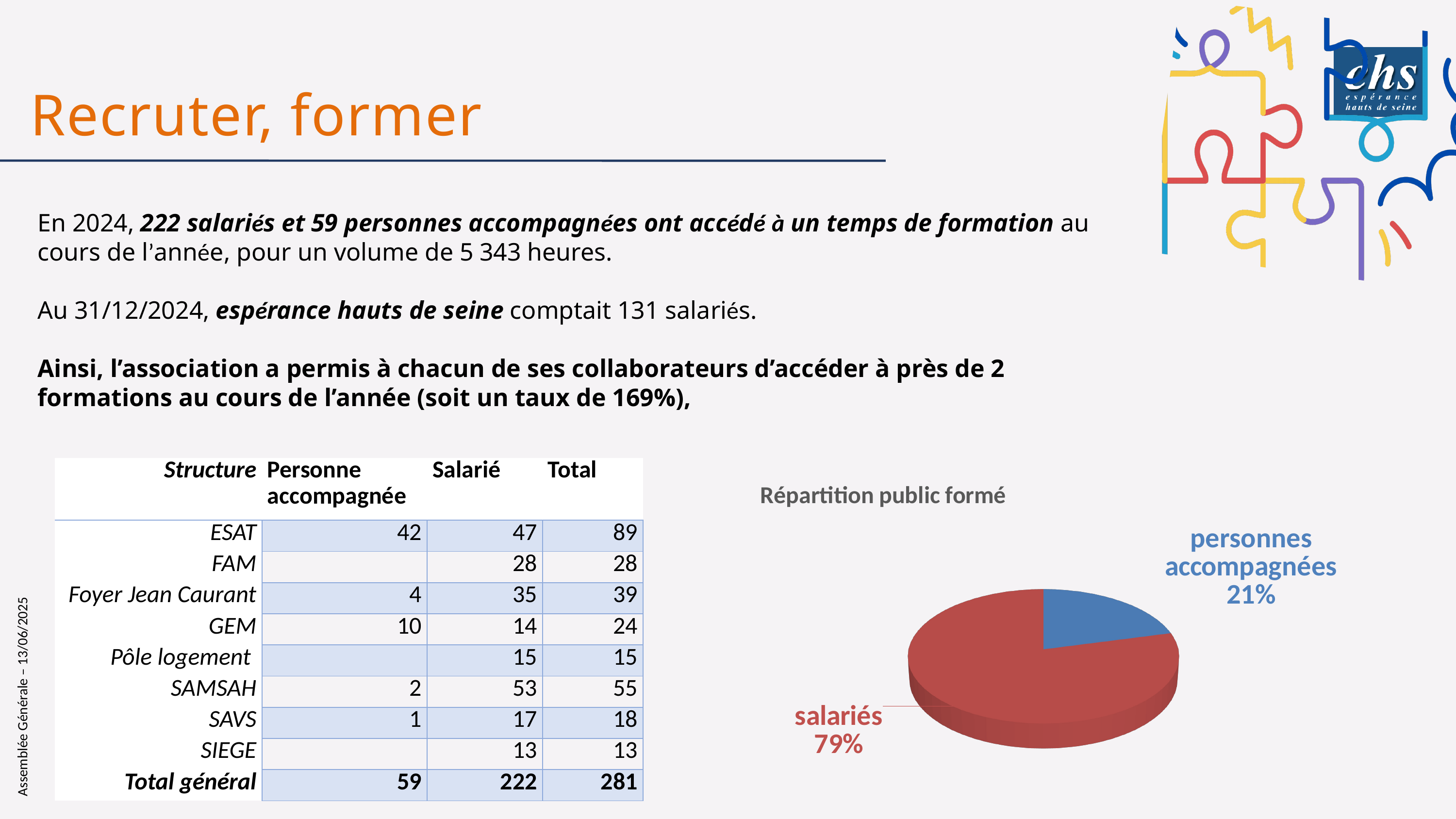
In the pie chart "Répartition public formé", what share is labelled for personnes accompagnées? 21% In the pie chart "Répartition public formé", by how many percentage points does the salariés share exceed the personnes accompagnées share? 58 In the pie chart "Répartition public formé", which slice is the smallest? personnes accompagnées What kind of chart is shown under the title "Répartition public formé"? pie chart In the pie chart "Répartition public formé", which is larger: the share for salariés or the share for personnes accompagnées? salariés In the pie chart "Répartition public formé", what share is labelled for salariés? 79% What is the title of the pie chart on the slide? Répartition public formé In the pie chart "Répartition public formé", what colour is the salariés slice? red In the pie chart "Répartition public formé", which slice is the largest? salariés How many slices does the pie chart "Répartition public formé" have? 2